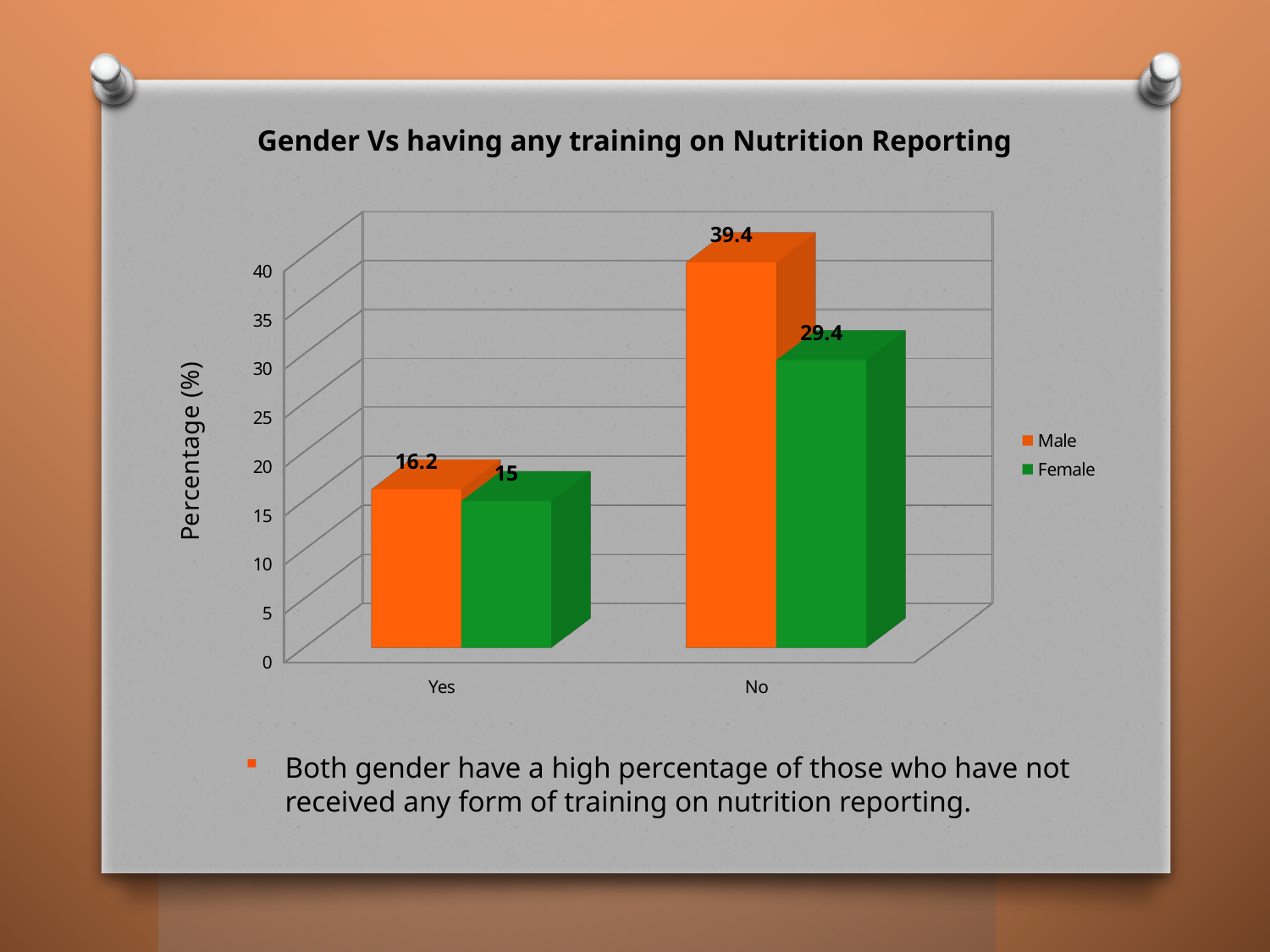
What is the Male value for the 'Yes' category? 16.2 What is the title of the chart? Gender Vs having any training on Nutrition Reporting What is the Male value for the 'No' category? 39.4 How many categories are shown on the x axis? 2 What is the Female value for the 'No' category? 29.4 Which category has the highest Male value? No Which is larger for the 'Yes' category, the Male value or the Female value? Male Which category has the lowest Female value? Yes How many series does the legend list? 2 What is the difference between the Male and Female values for the 'No' category? 10 What kind of chart is shown on the slide? Bar chart What is the Female value for the 'Yes' category? 15